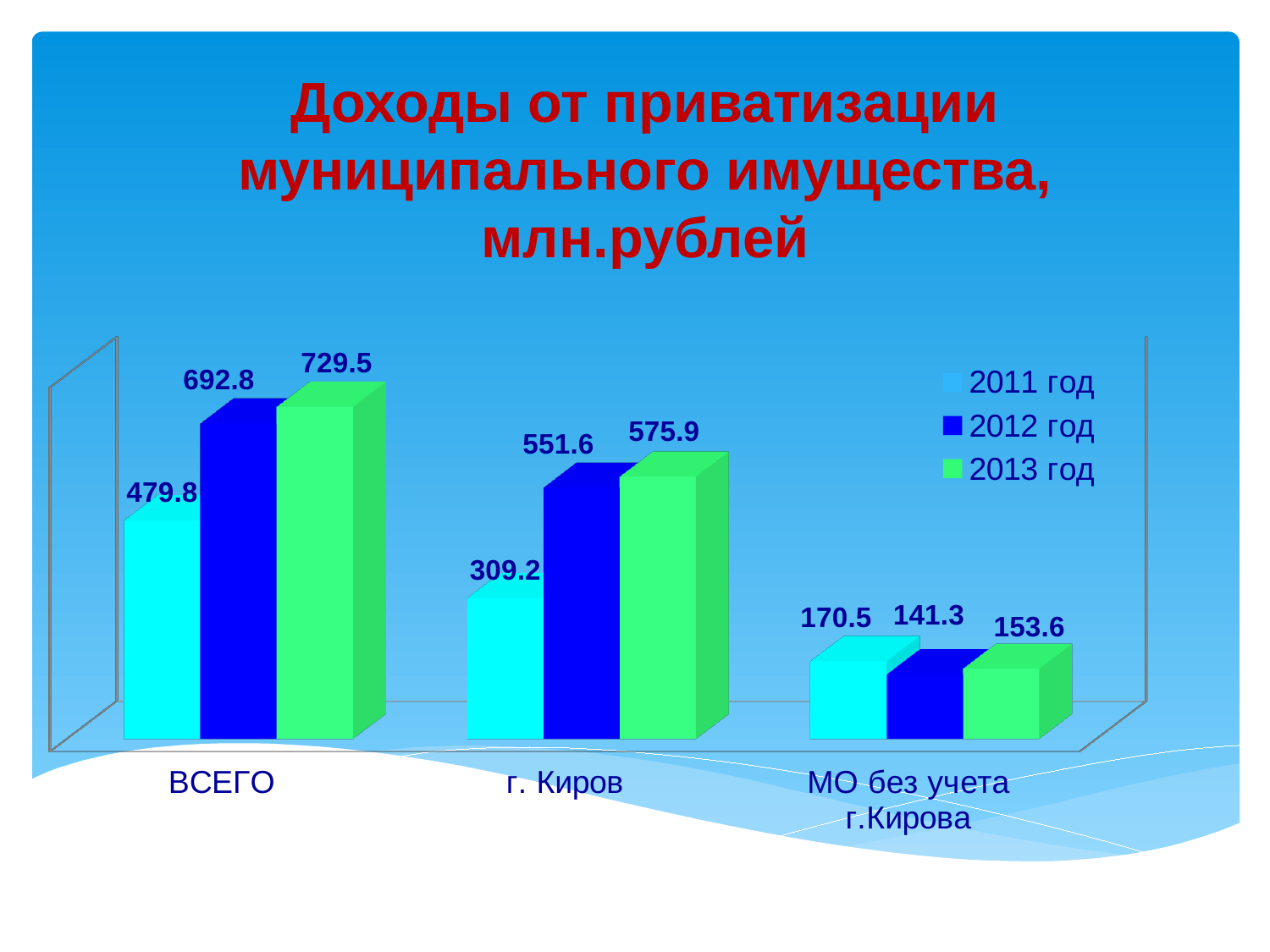
How many categories are shown on the x axis? 3 What is the value for ВСЕГО in 2013 год? 729.5 What is the value for МО без учета г.Кирова in 2012 год? 141.3 Which category has the lowest value in 2013 год? МО без учета г.Кирова What is the value for ВСЕГО in 2011 год? 479.8 Which is larger for МО без учета г.Кирова: the 2011 год value or the 2013 год value? 2011 год What is the difference between the 2013 год and 2012 год values for ВСЕГО? 36.7 How many series does the legend list? 3 What is the difference between the 2012 год and 2011 год values for г. Киров? 242.4 Which category has the highest value in 2012 год? ВСЕГО What is the value for г. Киров in 2011 год? 309.2 What kind of chart is shown on the slide? Bar chart